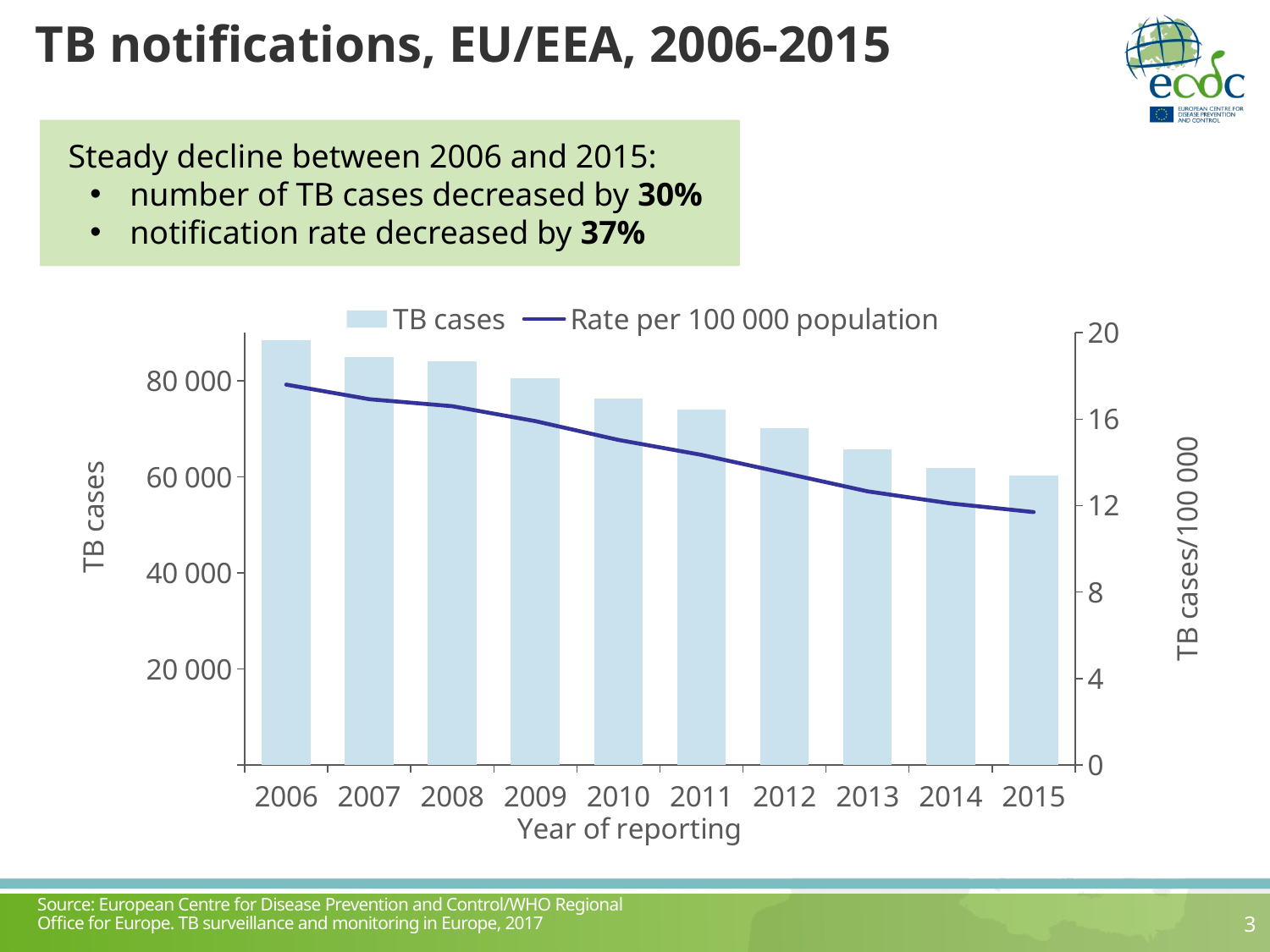
Is the number of TB cases in 2011 greater or less than 80 000? less What kind of chart is shown on the slide? A bar and line chart (bars for TB cases, a line for the rate) Is the rate per 100 000 population in 2015 greater or less than 12? less Is the number of TB cases in 2013 greater or less than 60 000? greater Which year has the highest number of TB cases in the chart? 2006 Which year has more TB cases, 2008 or 2012? 2008 How many years are shown on the x axis of the chart? 10 What is the label of the right-hand vertical axis of the chart? TB cases/100 000 How many series does the chart legend list? 2 Do the TB cases rise or fall from 2006 to 2015? fall